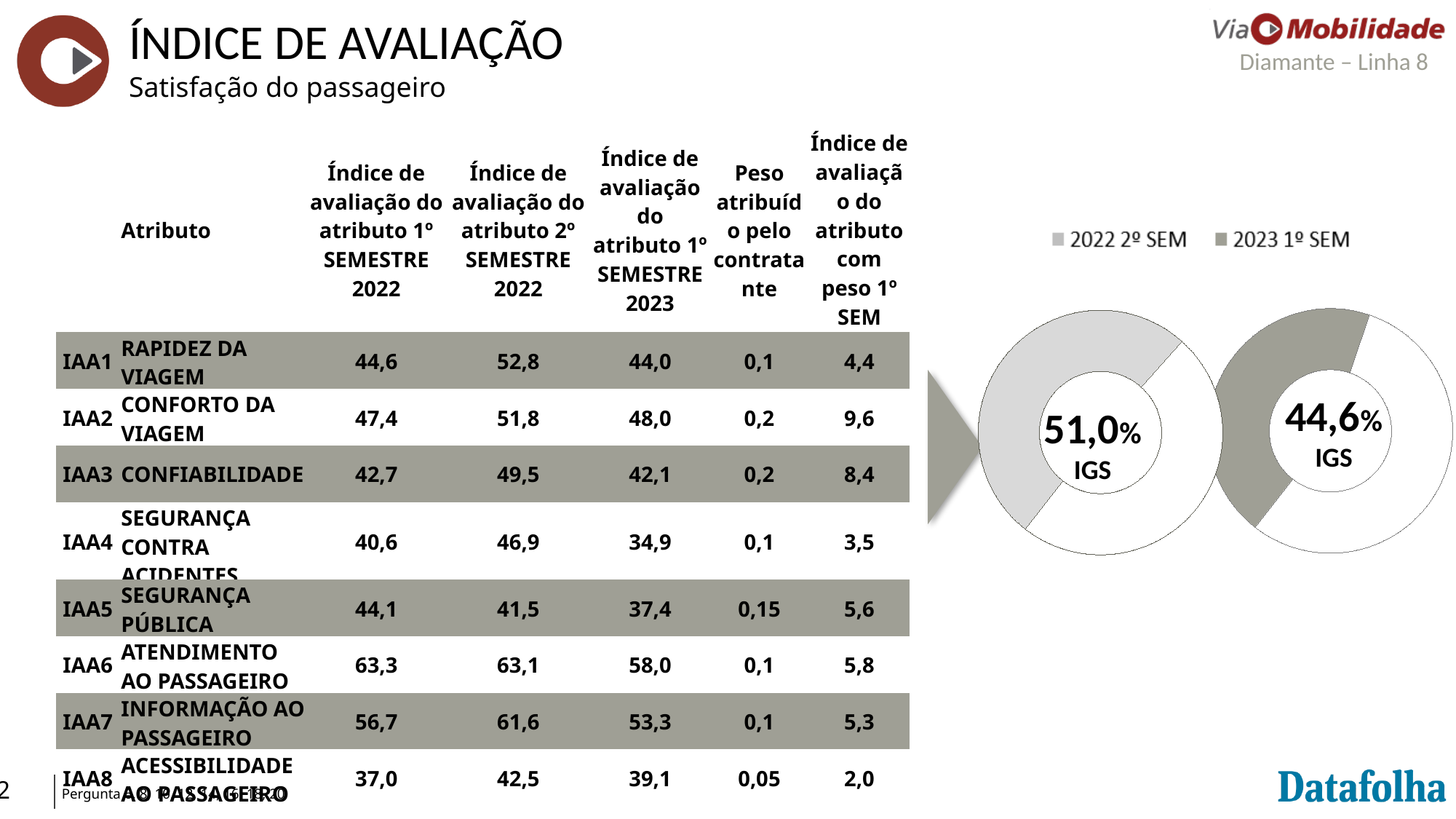
In the donut chart for 2022 2º SEM, what IGS value is shown in the centre? 51,0% Is the IGS for 2022 2º SEM in the donut chart greater or less than 50%? greater What kind of chart is used to show the IGS values on the right of the slide? Donut chart How many donut charts are shown on the slide? 2 What is the difference between the IGS for 2022 2º SEM and the IGS for 2023 1º SEM shown in the donut charts? 6,4 Did the IGS rise or fall from 2022 2º SEM to 2023 1º SEM according to the donut charts? Fall What share of the 2023 1º SEM donut does the filled (dark) slice represent? 44,6% Which period has the higher IGS in the donut charts, 2022 2º SEM or 2023 1º SEM? 2022 2º SEM What label appears below the percentage in the centre of each donut chart? IGS How many entries does the legend above the donut charts list? 2 Which legend entry is shown in the lighter grey colour above the donut charts? 2022 2º SEM In the donut chart for 2023 1º SEM, what IGS value is shown in the centre? 44,6%